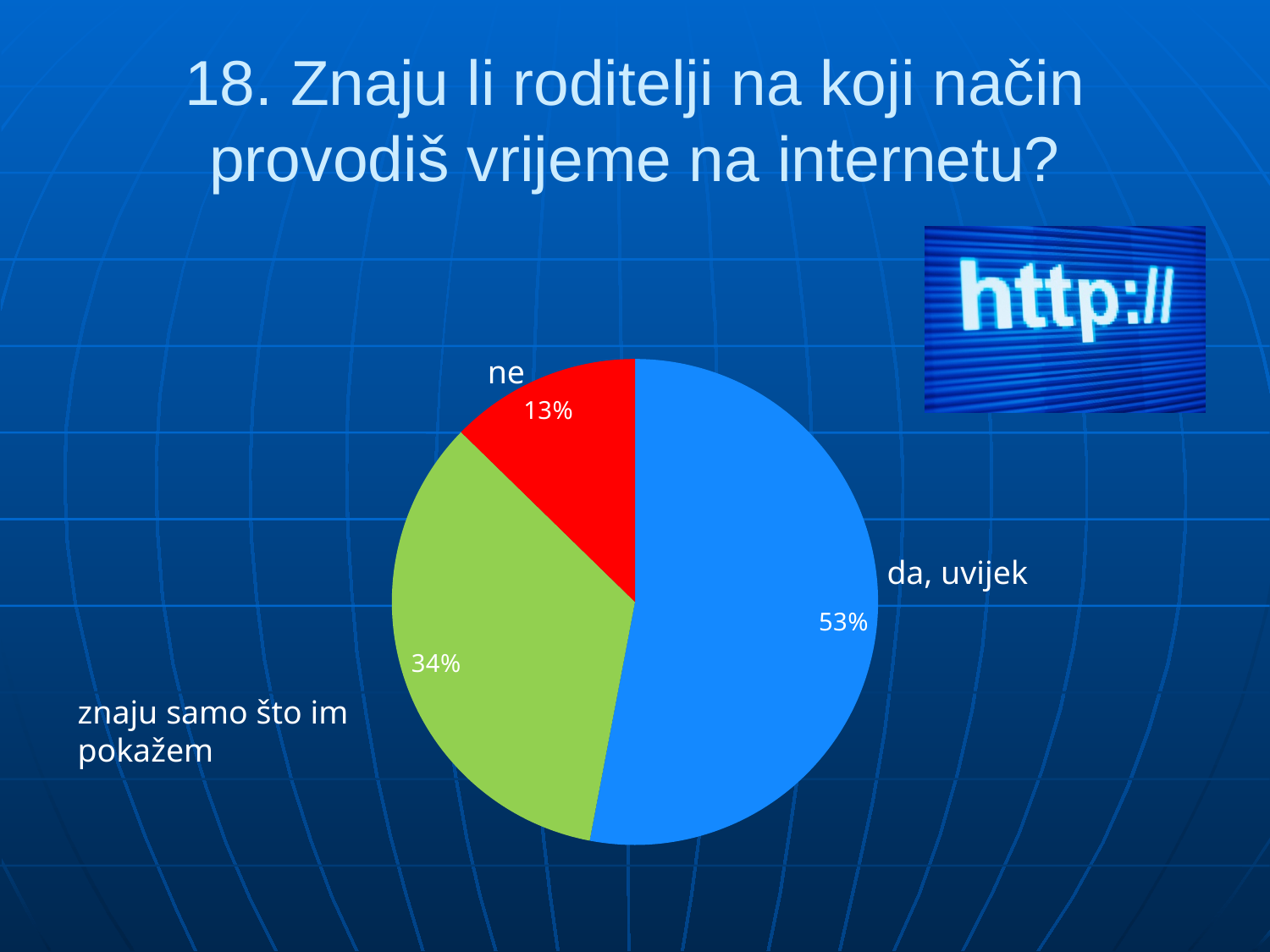
What share of the pie does "ne" have? 13% Which category has the largest slice of the pie? da, uvijek Which is larger, the slice for "znaju samo što im pokažem" or the slice for "ne"? znaju samo što im pokažem What share of the pie does "znaju samo što im pokažem" have? 34% How many slices does the pie chart have? 3 What colour is the slice for "ne"? red Which category has the smallest slice of the pie? ne What share of the pie does "da, uvijek" have? 53% What is the difference in percentage points between "znaju samo što im pokažem" and "ne"? 21 What kind of chart is shown on the slide? pie chart What is the difference in percentage points between "da, uvijek" and "ne"? 40 What colour is the slice for "da, uvijek"? blue